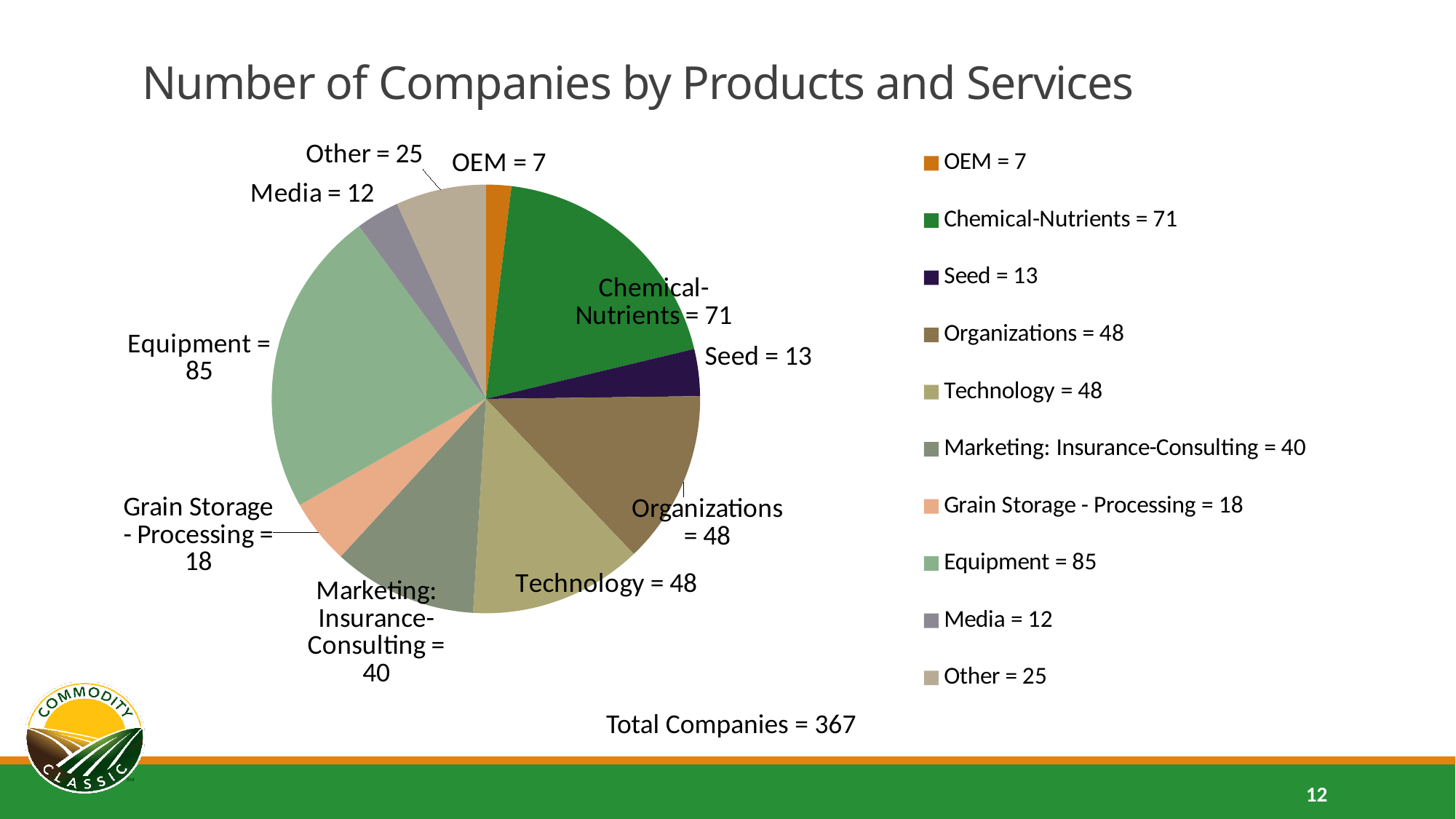
What type of chart is shown on the slide? Pie chart What is the difference between the number of companies in Equipment and in Chemical-Nutrients? 14 How many categories does the pie chart show? 10 Which has more companies, Seed or Grain Storage - Processing? Grain Storage - Processing What is the title of the chart? Number of Companies by Products and Services Which category has the largest number of companies? Equipment What is the difference between the Other and Media categories? 13 What is the number of companies for Chemical-Nutrients? 71 What is the total number of companies shown on the slide? 367 How many companies are in the Marketing: Insurance-Consulting category? 40 Which category has the smallest number of companies? OEM How many companies are in the Equipment category? 85